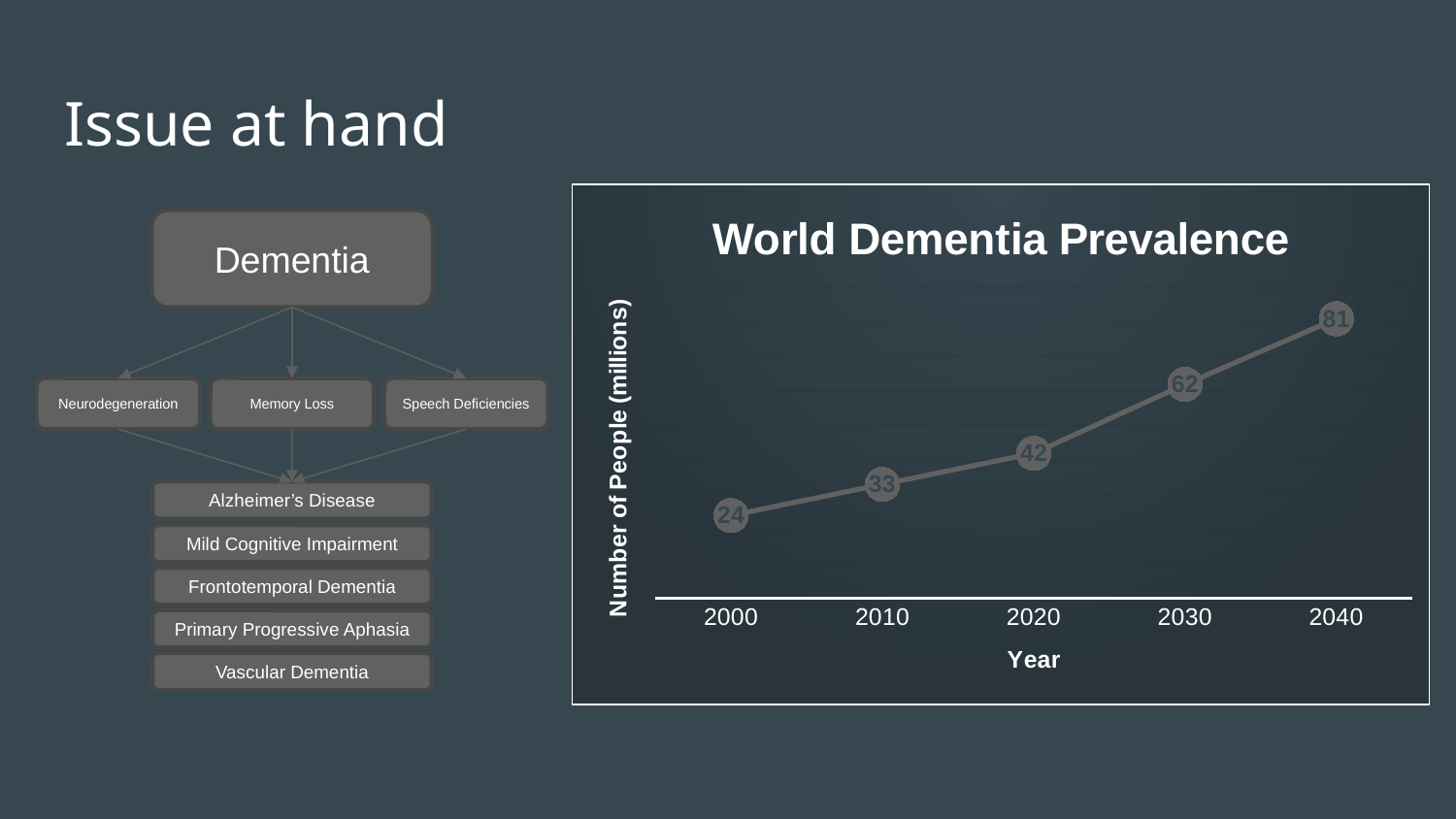
What kind of chart is the World Dementia Prevalence chart? line chart What is the value for 2000 in the World Dementia Prevalence chart? 24 Which year has the highest value in the World Dementia Prevalence chart? 2040 Which year has the lowest value in the World Dementia Prevalence chart? 2000 What is the value for 2020 in the World Dementia Prevalence chart? 42 What is the difference between the values for 2030 and 2020 in the World Dementia Prevalence chart? 20 What is the value for 2040 in the World Dementia Prevalence chart? 81 What is the difference between the values for 2040 and 2000 in the World Dementia Prevalence chart? 57 Which is larger in the World Dementia Prevalence chart, the value for 2010 or the value for 2030? 2030 How many data points are plotted in the World Dementia Prevalence chart? 5 Do the values in the World Dementia Prevalence chart rise or fall from 2000 to 2040? rise What is the y-axis label of the World Dementia Prevalence chart? Number of People (millions)